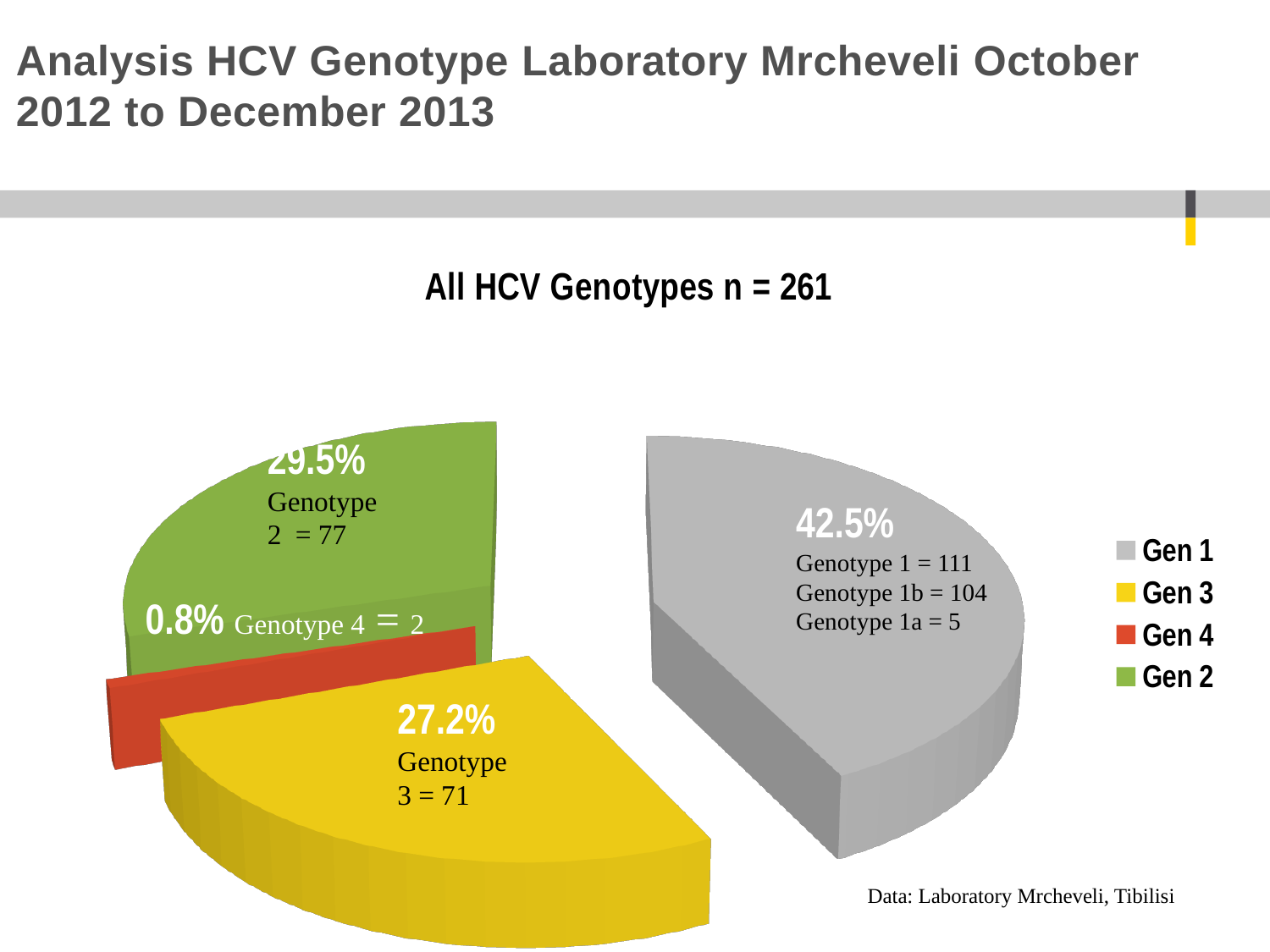
What is the difference in cases between Genotype 2 and Genotype 3? 6 How many entries does the legend list? 4 What kind of chart is shown on the slide? pie chart What percentage share does Genotype 1 have? 42.5% Which genotype has the largest slice of the pie? Genotype 1 How many cases are labelled for Genotype 1b? 104 What percentage share does Genotype 3 have? 27.2% What percentage share does Genotype 2 have? 29.5% How many cases are labelled for Genotype 2? 77 Which genotype has the smallest slice of the pie? Genotype 4 What is the chart's title? All HCV Genotypes n = 261